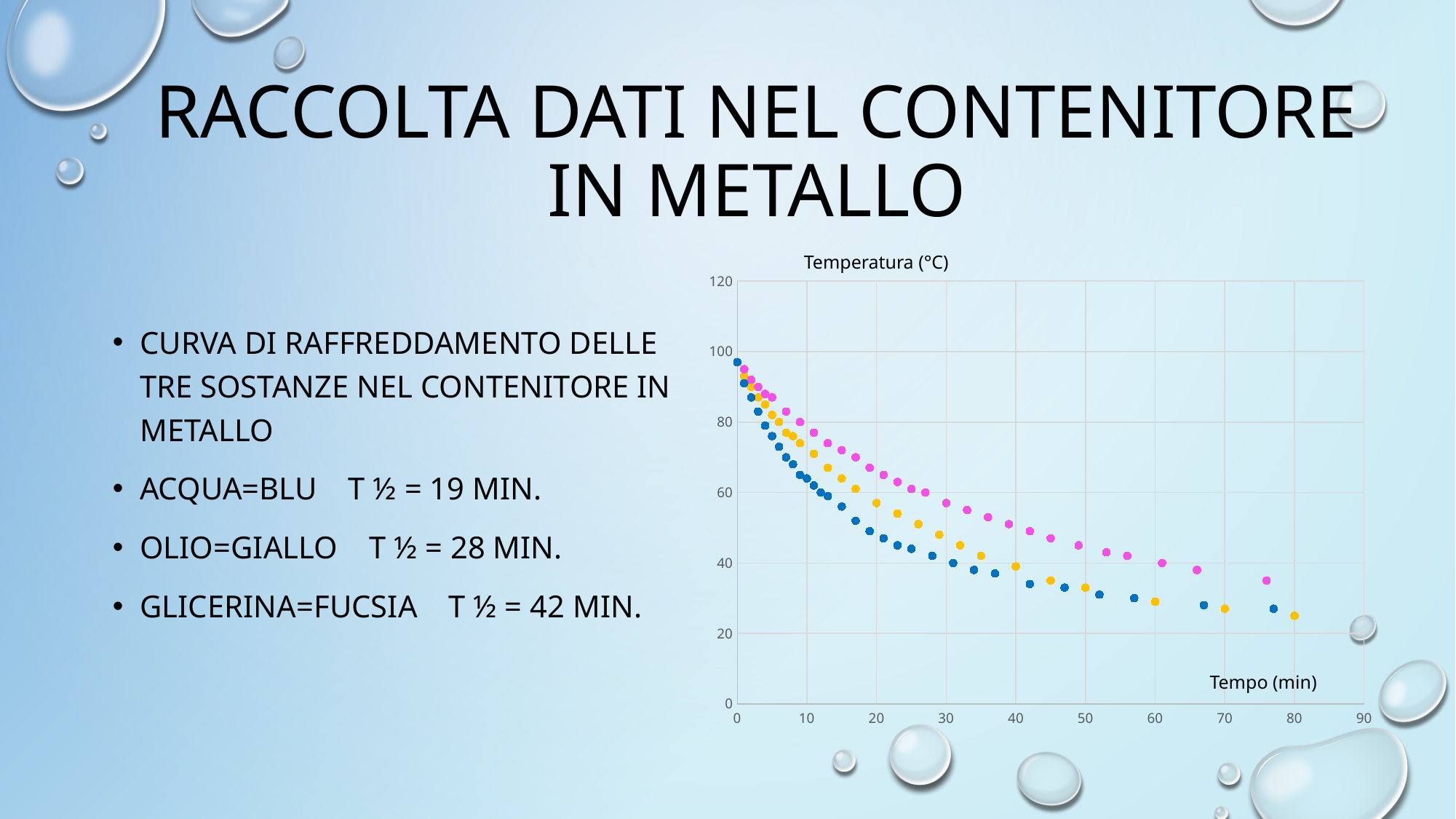
What is the label of the vertical axis of the chart? Temperatura (°C) Which series stays at the highest temperature throughout the cooling period? fuchsia (glicerina) At 40 min, which series has the higher temperature, the fuchsia (glicerina) or the blue (acqua)? fuchsia (glicerina) Is the temperature of the fuchsia (glicerina) series at 40 min greater or less than 40? greater Is the temperature of the blue (acqua) series at 20 min greater or less than 60? less What is the label of the horizontal axis of the chart? Tempo (min) How many series of points are plotted on the chart? 3 Is the temperature of the yellow (olio) series at 60 min greater or less than 40? less At 20 min, which series has the higher temperature, the yellow (olio) or the blue (acqua)? yellow (olio) Do the temperature values rise or fall as time increases along the x axis? fall What kind of chart is shown on the slide? scatter chart